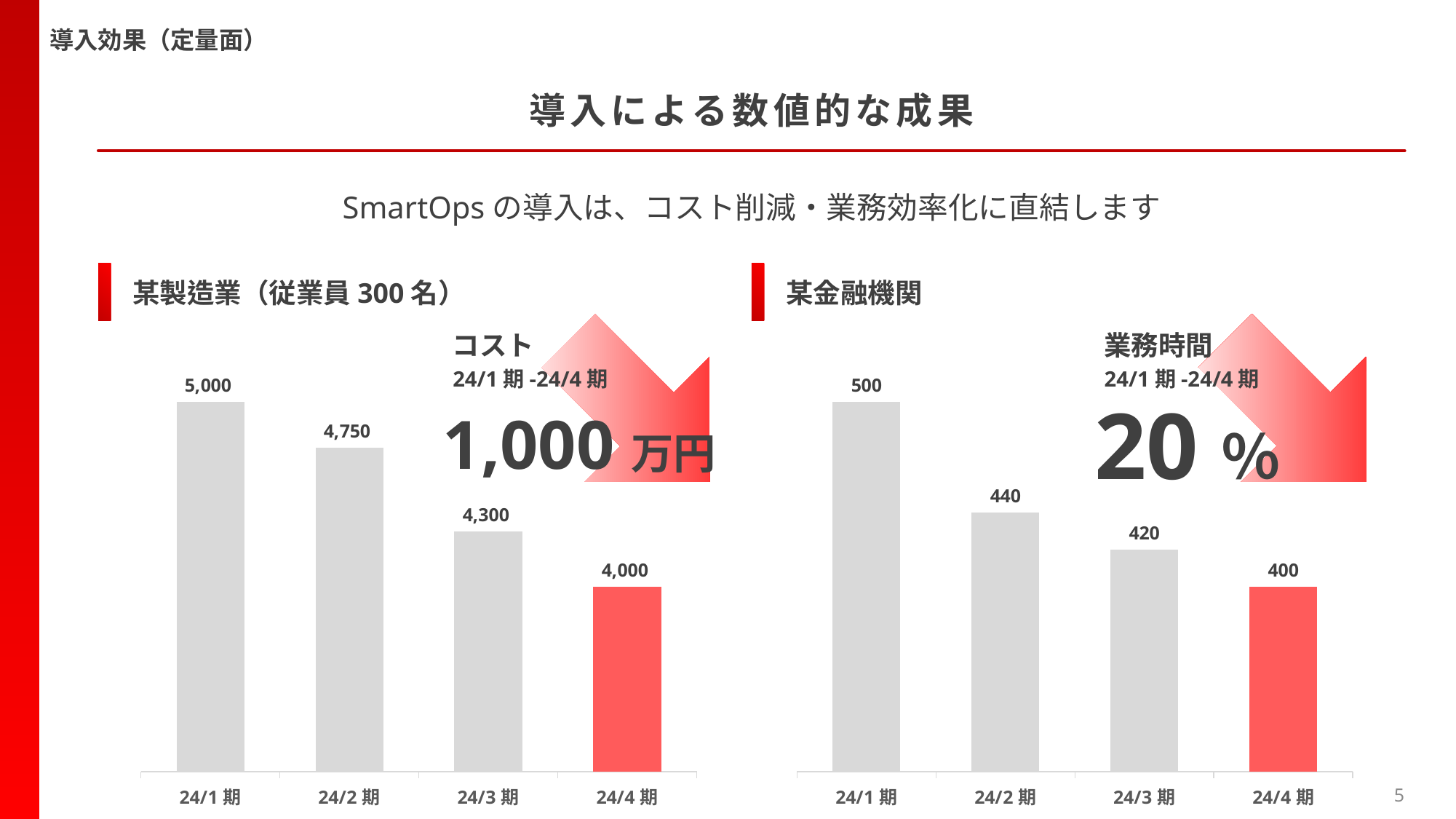
How many periods are shown on the x axis of the right chart (某金融機関)? 4 In the left chart (某製造業), which period has the lowest value? 24/4期 In the right chart (某金融機関), what is the value for 24/2期? 440 In the right chart (某金融機関), what is the difference between the values for 24/2期 and 24/3期? 20 In the left chart (某製造業), what is the value for 24/1期? 5,000 In the left chart (某製造業), which is larger, the value for 24/2期 or 24/3期? 24/2期 In the right chart (某金融機関), which period has the highest value? 24/1期 In the left chart (某製造業), what is the value for 24/3期? 4,300 In the right chart (某金融機関), what is the value for 24/4期? 400 In the left chart (某製造業), what is the difference between the values for 24/1期 and 24/4期? 1,000 What kind of chart is the left chart (某製造業)? Bar chart In the right chart (某金融機関), do the values rise or fall from 24/1期 to 24/4期? Fall